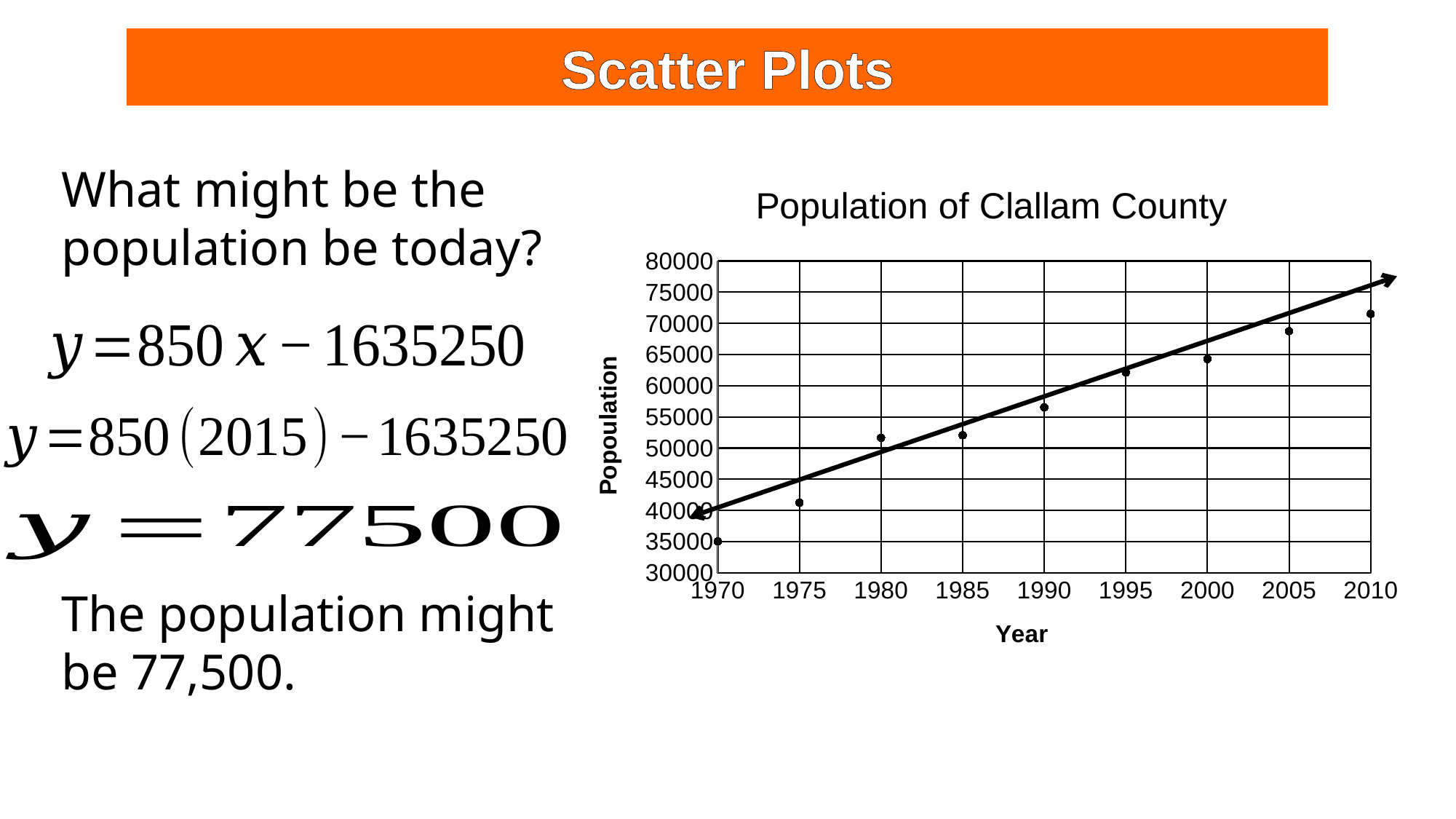
What is the title of the chart? Population of Clallam County Is the population value for 1995 greater or less than 60000? greater How many data points are plotted on the chart? 9 Which year has the lowest plotted population? 1970 What kind of chart is shown on the slide? scatter plot Is the population value for 1990 greater or less than 60000? less Is the population value for 2010 greater or less than 70000? greater Do the plotted population values rise or fall as the year increases? rise Which year has the larger plotted population, 2000 or 1980? 2000 What is the label of the x axis of the chart? Year Which year has the highest plotted population? 2010